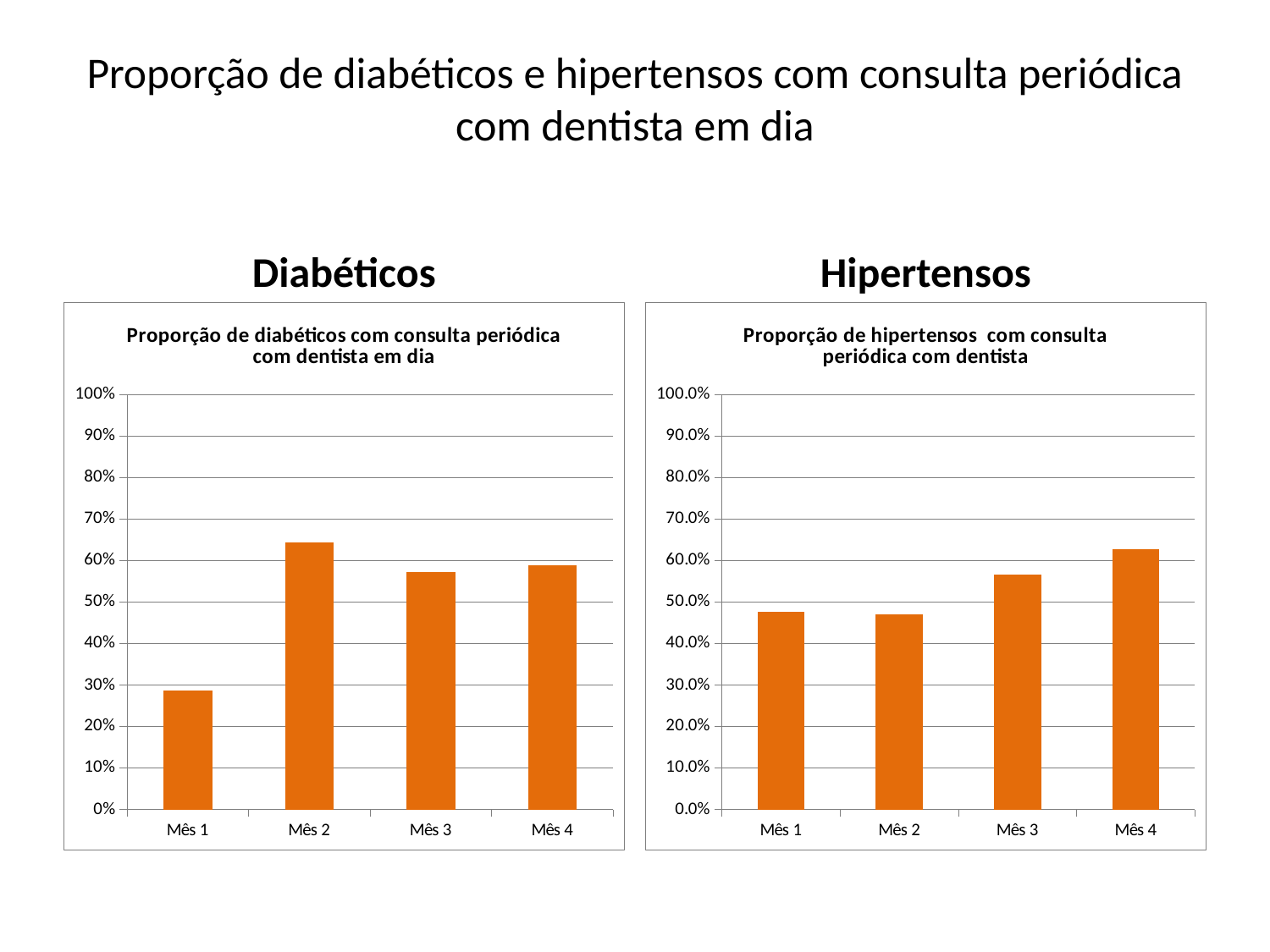
In the Diabéticos chart, which month has the lowest value? Mês 1 In the Hipertensos chart, is the value for Mês 1 greater or less than 50.0%? less In the Diabéticos chart, which month has the highest value? Mês 2 In the Hipertensos chart, which is larger, the value for Mês 3 or the value for Mês 1? Mês 3 How many categories are shown on the x axis of the Hipertensos chart? 4 In the Diabéticos chart, which is larger, the value for Mês 2 or the value for Mês 3? Mês 2 In the Hipertensos chart, is the value for Mês 4 greater or less than 60.0%? greater In the Diabéticos chart, is the value for Mês 2 greater or less than 60%? greater What kind of chart is the Diabéticos chart? bar chart What is the title of the chart on the right side of the slide? Proporção de hipertensos com consulta periódica com dentista In the Hipertensos chart, which month has the highest value? Mês 4